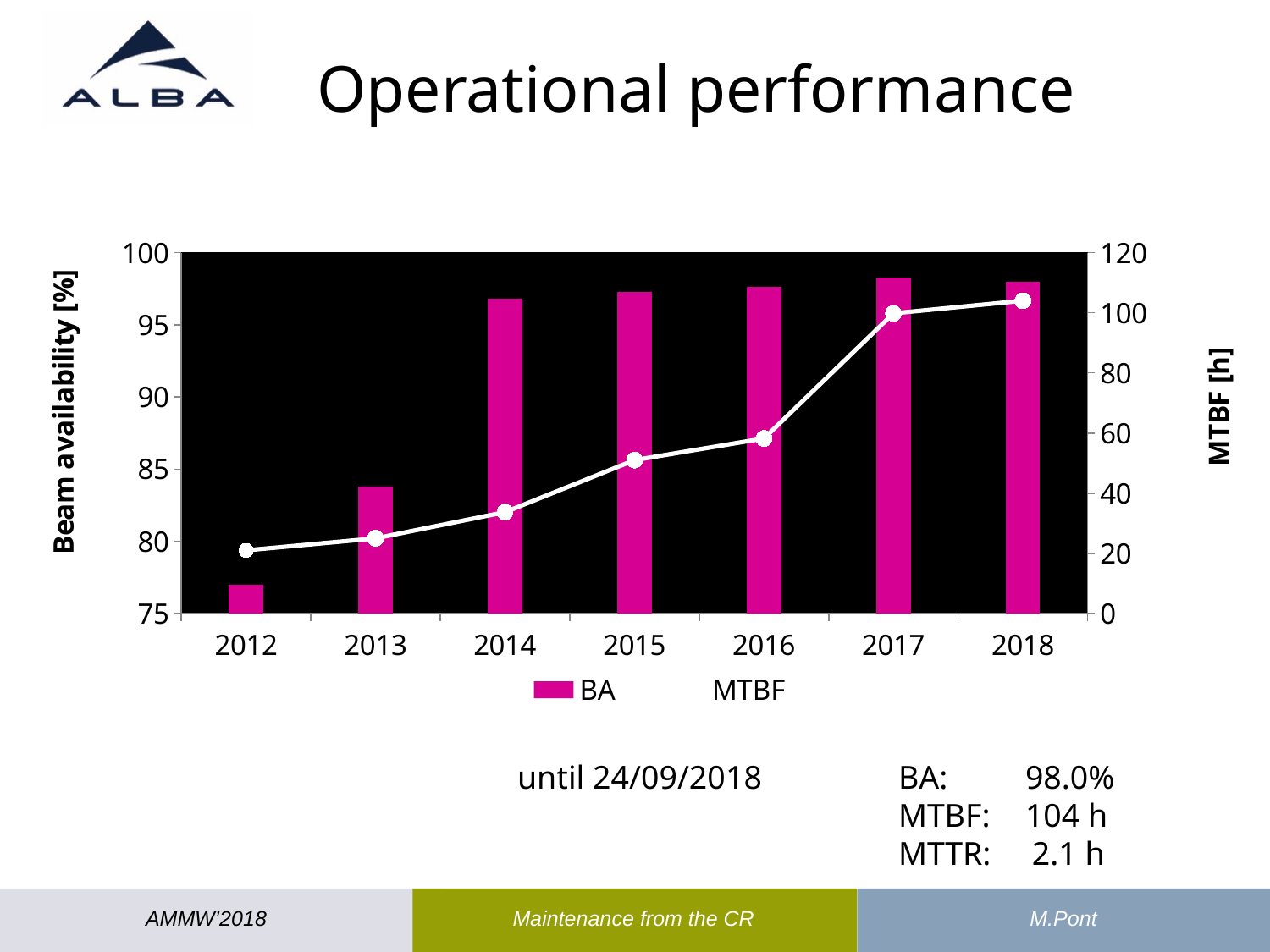
Which year has the larger BA bar, 2013 or 2014? 2014 Is the BA value for 2014 greater or less than 95? greater What is the MTBF for 2018 according to the slide? 104 h What is the beam availability (BA) for 2018 according to the slide? 98.0% Which year has the lowest MTBF value on the line? 2012 Is the BA value for 2013 greater or less than 85? less Is the MTBF value for 2014 greater or less than 40? less How many years are shown on the x axis of the chart? 7 Which year has the lowest beam availability (BA) bar? 2012 Does the MTBF line generally rise or fall from 2012 to 2018? rise How many series does the chart legend list? 2